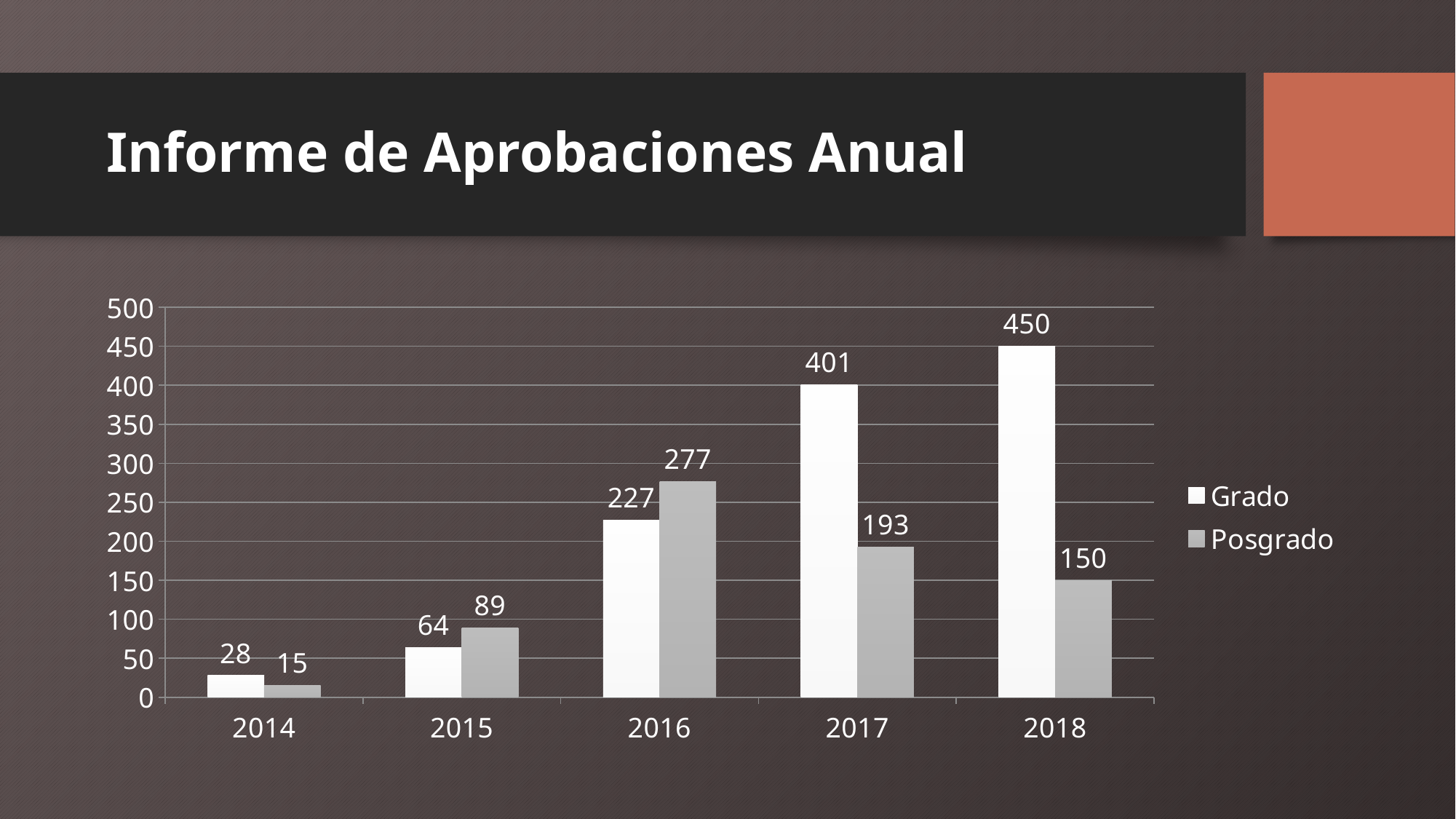
What is the difference between the Grado and Posgrado values in 2018? 300 Which year has the lowest Posgrado value? 2014 Do the Grado values rise or fall from 2014 to 2018? Rise Which year has the highest Grado value? 2018 How many series does the legend list? 2 What is the title of the slide? Informe de Aprobaciones Anual What is the Posgrado value for 2016? 277 In 2015, which series has the larger value, Grado or Posgrado? Posgrado What is the Grado value for 2017? 401 How many years are shown on the x axis? 5 What is the Posgrado value for 2014? 15 What kind of chart is shown on the slide? Bar chart